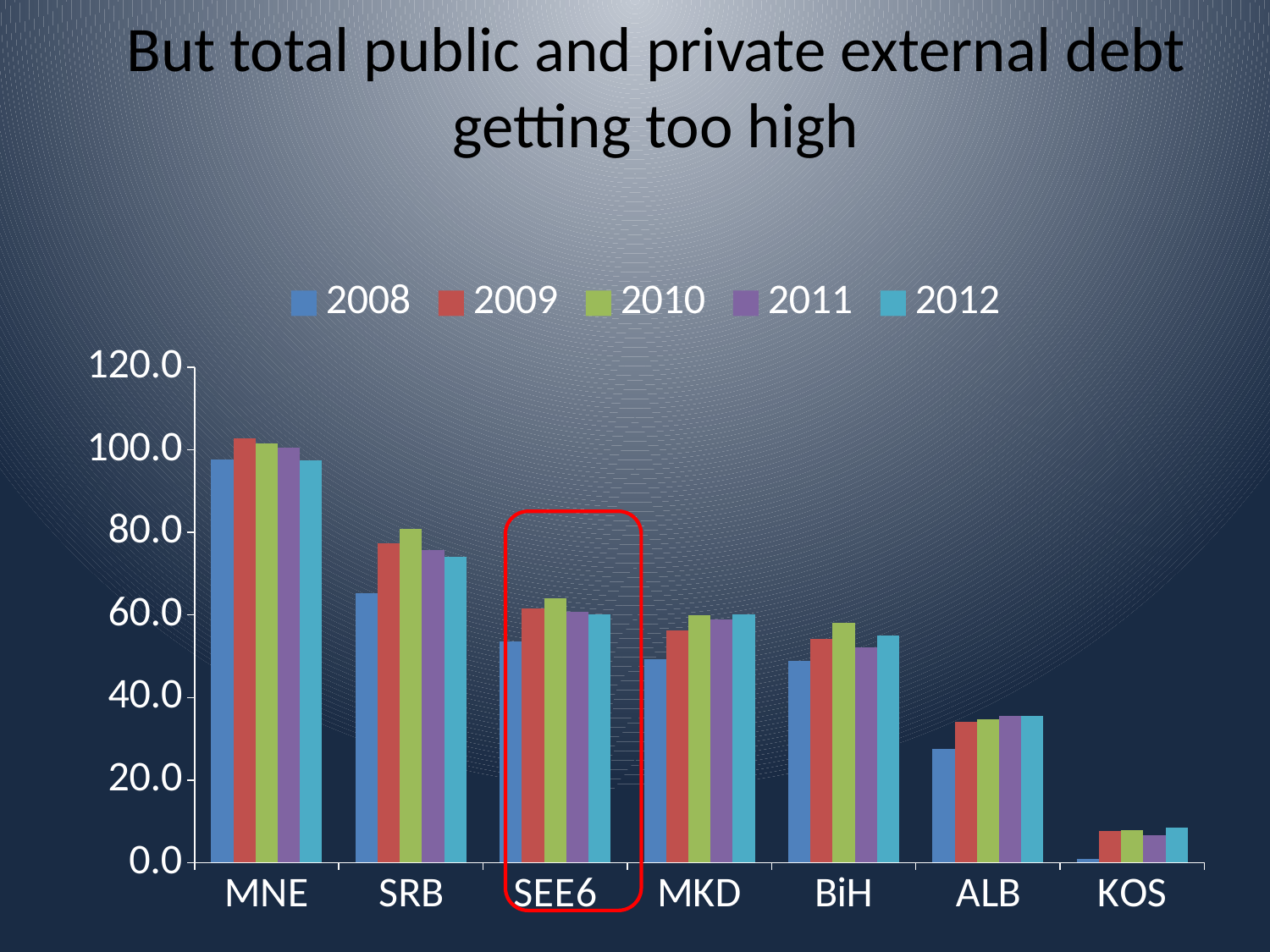
Is the value for ALB in 2008 greater or less than 20? greater Which is larger, the 2012 value for BiH or the 2012 value for ALB? BiH Which category is highlighted with a red box on the chart? SEE6 Which category has the highest values overall? MNE Which category has the lowest values overall? KOS How many categories are shown on the x axis? 7 For SRB, which year has the highest value? 2010 Is the value for KOS in 2012 greater or less than 20? less What kind of chart is shown on the slide? bar chart Is the value for SRB in 2008 greater or less than 60? greater How many series does the legend list? 5